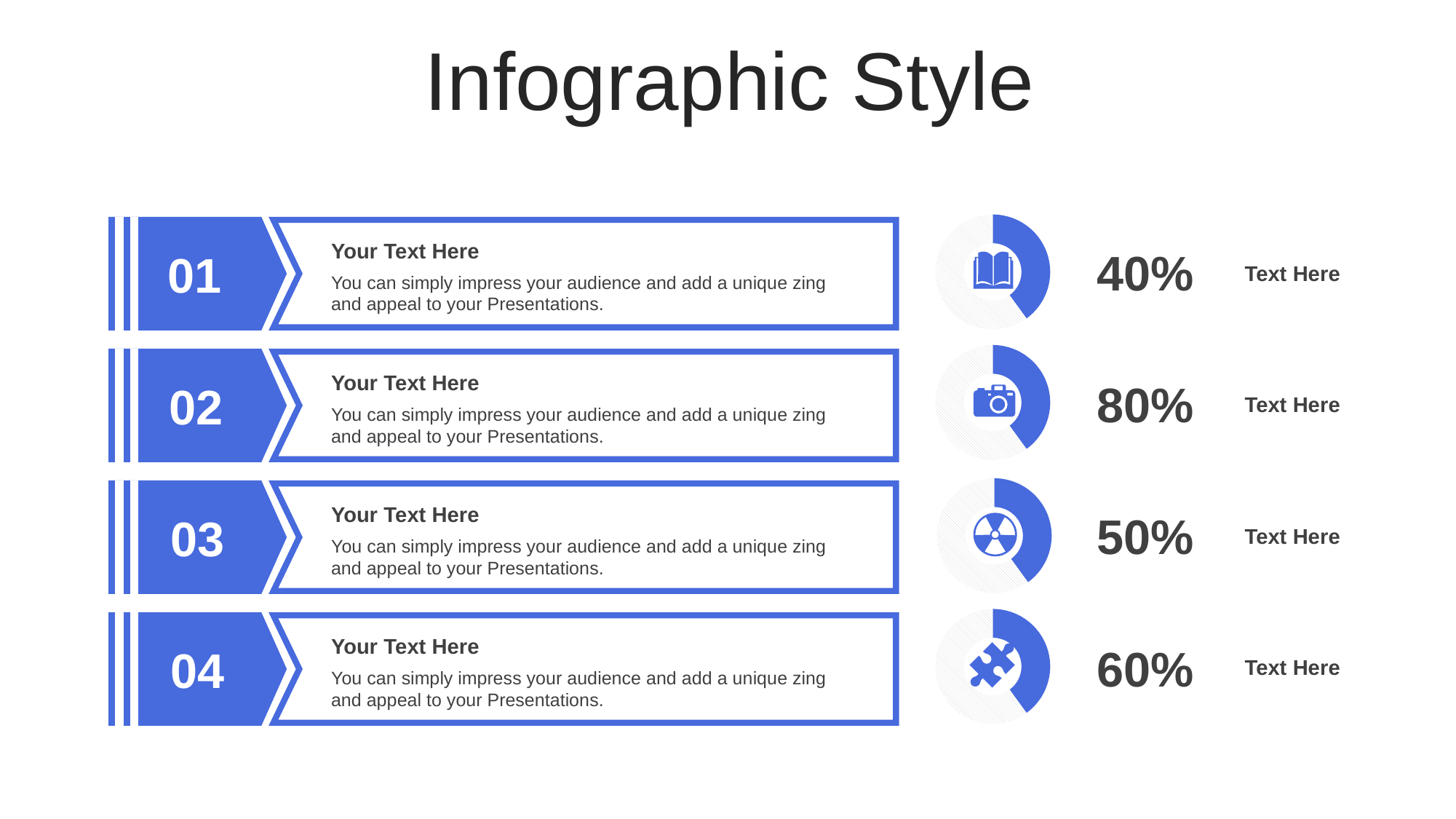
Which of the four donut charts shows the highest percentage? The second one (camera icon), 80% What percentage is shown next to the third donut chart (the one with the radiation icon)? 50% Which of the four donut charts shows the lowest percentage? The top one (book icon), 40% What percentage is shown next to the bottom donut chart (the one with the puzzle icon)? 60% Which is larger, the percentage of the third donut chart or the bottom donut chart? The bottom donut chart (60%) What colour is the filled portion of each donut chart? Blue What percentage is shown next to the top donut chart (the one with the book icon)? 40% How many donut charts are shown on the slide? 4 What is the difference between the percentage of the second donut chart and the top donut chart? 40% What is the difference between the percentages of the bottom donut chart and the third donut chart? 10% What percentage is shown next to the second donut chart (the one with the camera icon)? 80% What kind of chart is used to show the percentages on the right side of the slide? Donut (pie) chart